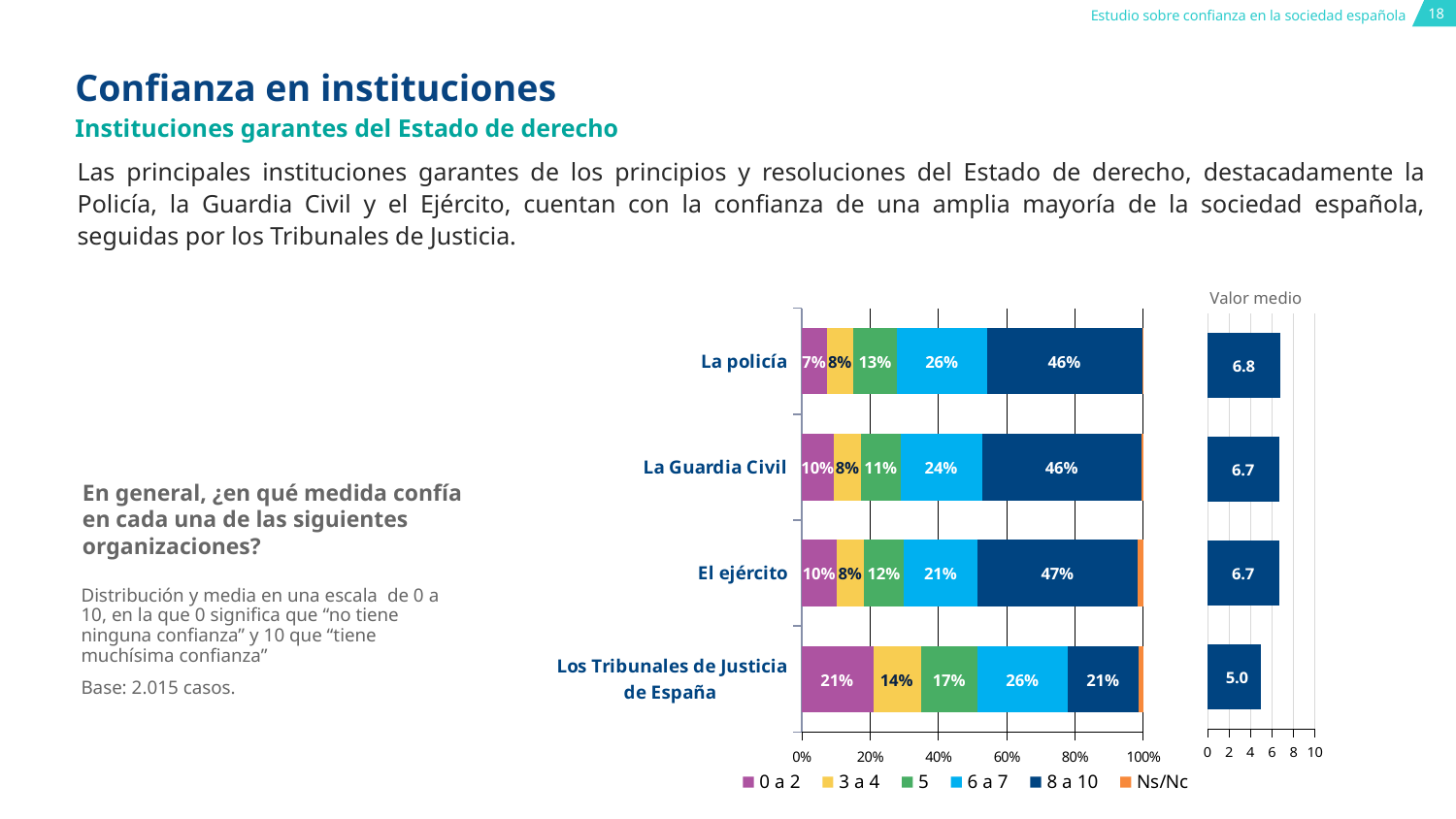
How many institutions are shown in the stacked bar chart? 4 In the stacked bar chart, what is the 0 a 2 share for Los Tribunales de Justicia de España? 21% In the Valor medio chart, which institution has the lowest mean value? Los Tribunales de Justicia de España In the stacked bar chart, what percentage of respondents gave La policía a score of 8 a 10? 46% In the Valor medio chart, what is the mean value for El ejército? 6.7 What type of chart is the chart on the left showing the distribution of scores? Stacked bar chart In the stacked bar chart, is the 0 a 2 share larger for La Guardia Civil or for La policía? La Guardia Civil In the Valor medio chart, what is the difference between the mean value for La policía and for Los Tribunales de Justicia de España? 1.8 In the stacked bar chart, what is the difference between the 6 a 7 share for La policía and for El ejército? 5 percentage points In the stacked bar chart, which institution has the highest 8 a 10 share? El ejército How many series does the legend of the stacked bar chart list? 6 In the Valor medio chart, which institution has the highest mean value? La policía